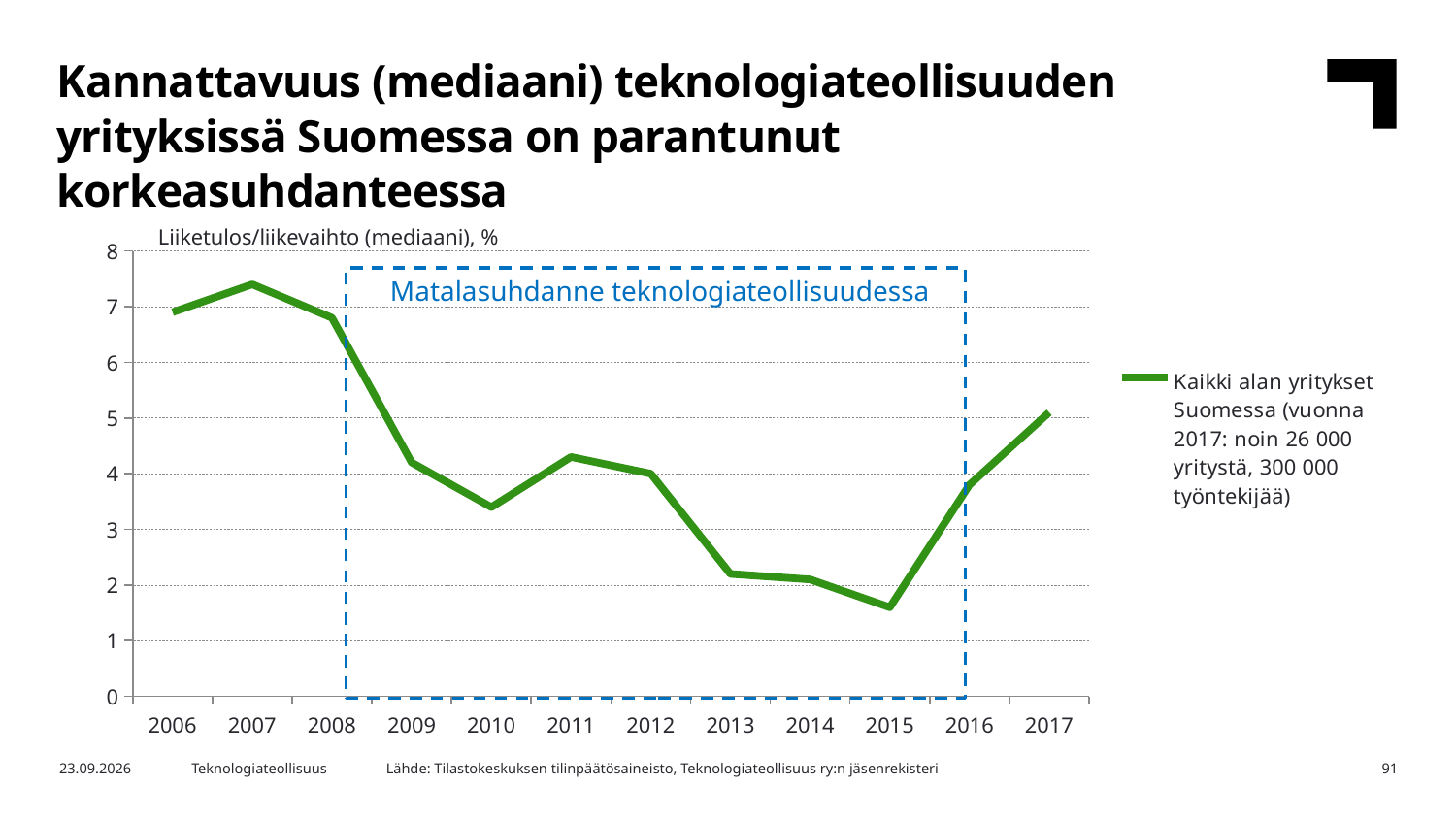
In which year is the median operating profit/turnover lowest? 2015 How many years are plotted on the x axis? 12 Do the values rise or fall from 2015 to 2017? rise Is the value for 2007 greater or less than 7? greater In which year is the median operating profit/turnover highest? 2007 What label is written inside the dashed box on the chart? Matalasuhdanne teknologiateollisuudessa Is the value for 2010 greater or less than 4? less How many series does the legend list? 1 What kind of chart is shown on the slide? Line chart Do the values rise or fall from 2012 to 2015? fall Is the value for 2015 greater or less than 2? less Which year has the larger value, 2010 or 2011? 2011